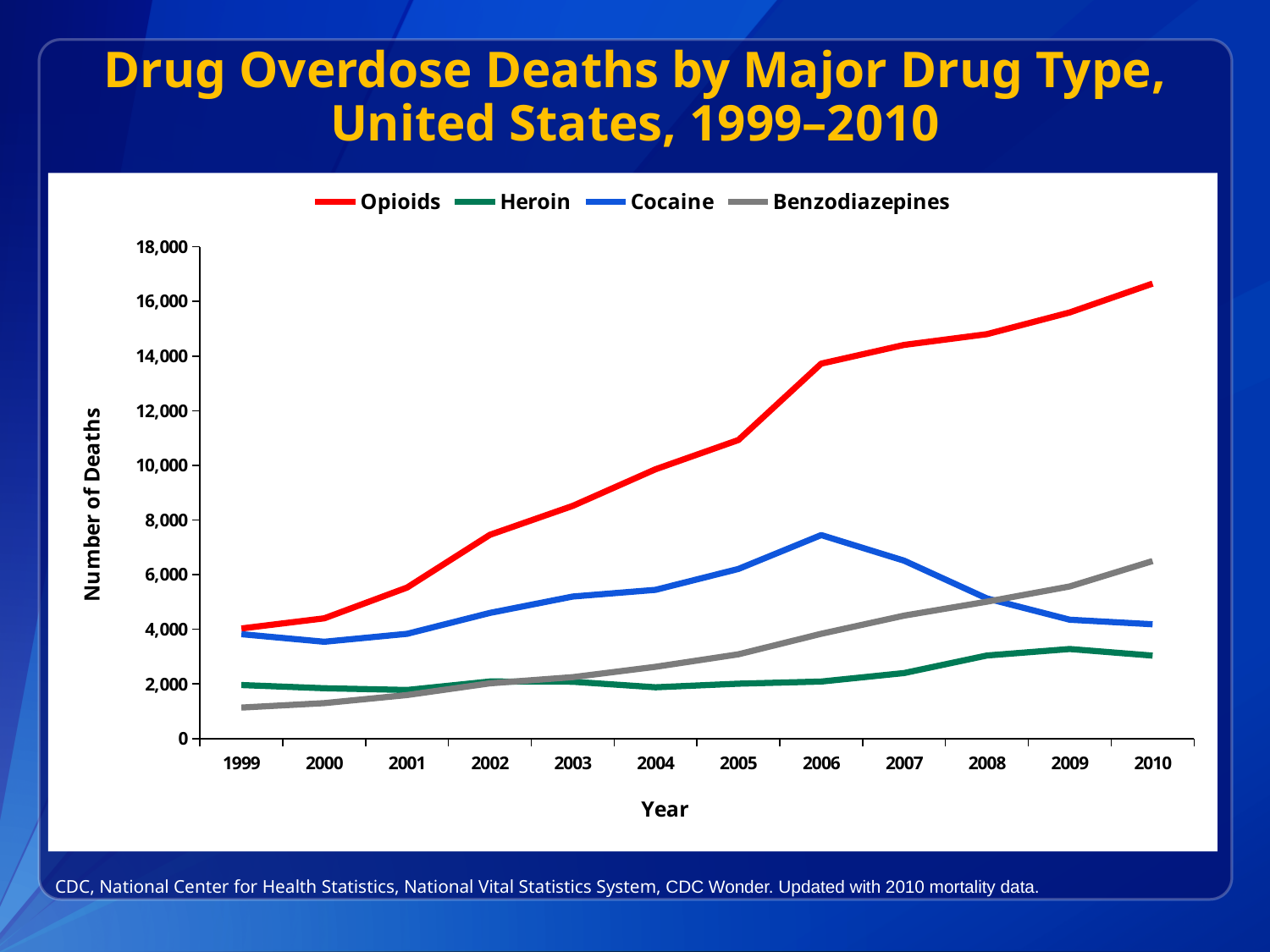
What is the title of the chart? Drug Overdose Deaths by Major Drug Type, United States, 1999–2010 In 2006, which is larger: Cocaine deaths or Heroin deaths? Cocaine Is the value for Opioids in 2010 greater or less than 16,000? greater Do Opioid deaths rise or fall from 1999 to 2010? Rise Which drug type has the highest number of deaths in 2010? Opioids Which drug type has the lowest number of deaths in 1999? Benzodiazepines In which year does the Cocaine line reach its peak? 2006 How many series does the legend list? 4 What kind of chart is shown on the slide? Line chart In 2010, which is larger: Cocaine deaths or Benzodiazepine deaths? Benzodiazepines How many years are plotted along the x axis? 12 Is the value for Benzodiazepines in 1999 greater or less than 2,000? less